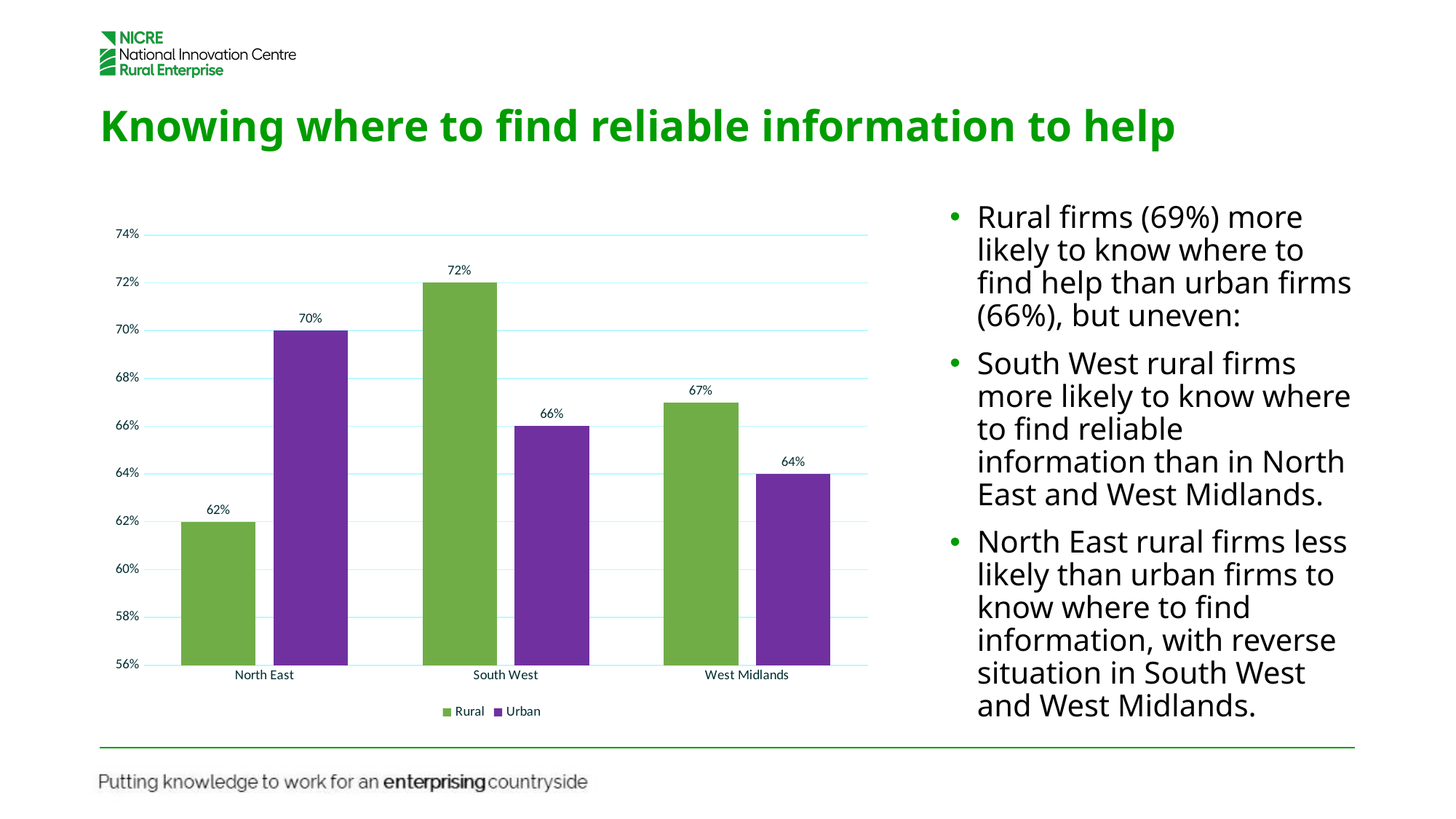
What is the difference between the Rural and Urban values for North East? 8% What colour are the Urban bars? purple Which region has the lowest Urban value? West Midlands What kind of chart is shown on the slide? bar chart Is the Rural value for North East greater or less than 64%? less How many series does the legend list? 2 What is the Rural value for South West? 72% What is the Urban value for West Midlands? 64% Which is larger for West Midlands, the Rural value or the Urban value? Rural Which region has the highest Rural value? South West How many regions are shown on the x axis? 3 What is the Urban value for North East? 70%